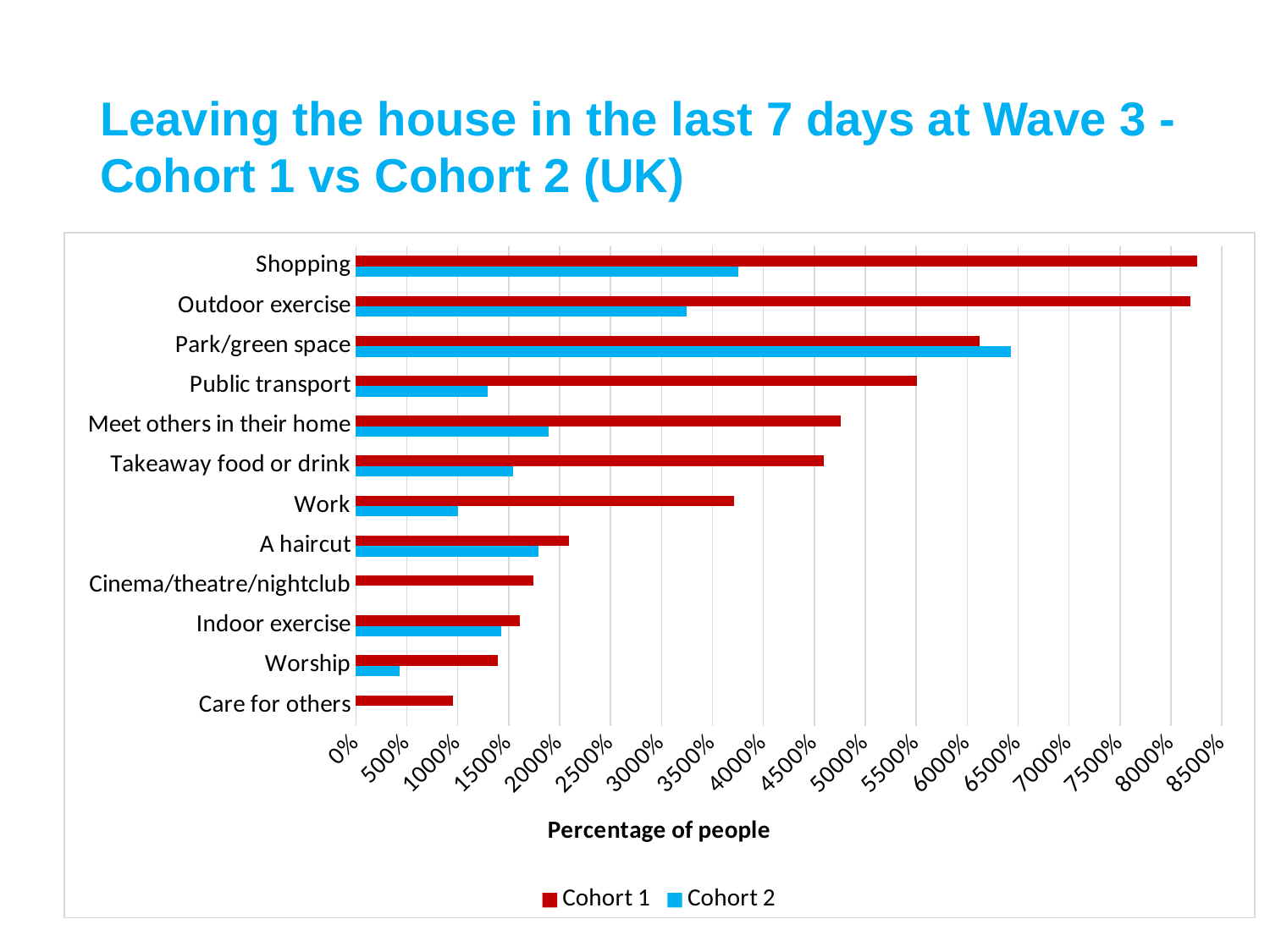
How many activity categories are shown on the chart? 12 For Park/green space, which cohort has the larger value? Cohort 2 Which category has the highest Cohort 2 value? Park/green space How many series does the legend list? 2 Which colour represents Cohort 2 in the legend? Blue What is the title of the horizontal axis? Percentage of people Is the Cohort 2 value for Public transport greater or less than 1500%? less Is the Cohort 1 value for Shopping greater or less than 8000%? greater Is the Cohort 2 value for Worship greater or less than 500%? less What kind of chart is shown on the slide? Bar chart Which category has the lowest Cohort 1 value? Care for others For Cohort 1, which is larger: Public transport or Meet others in their home? Public transport